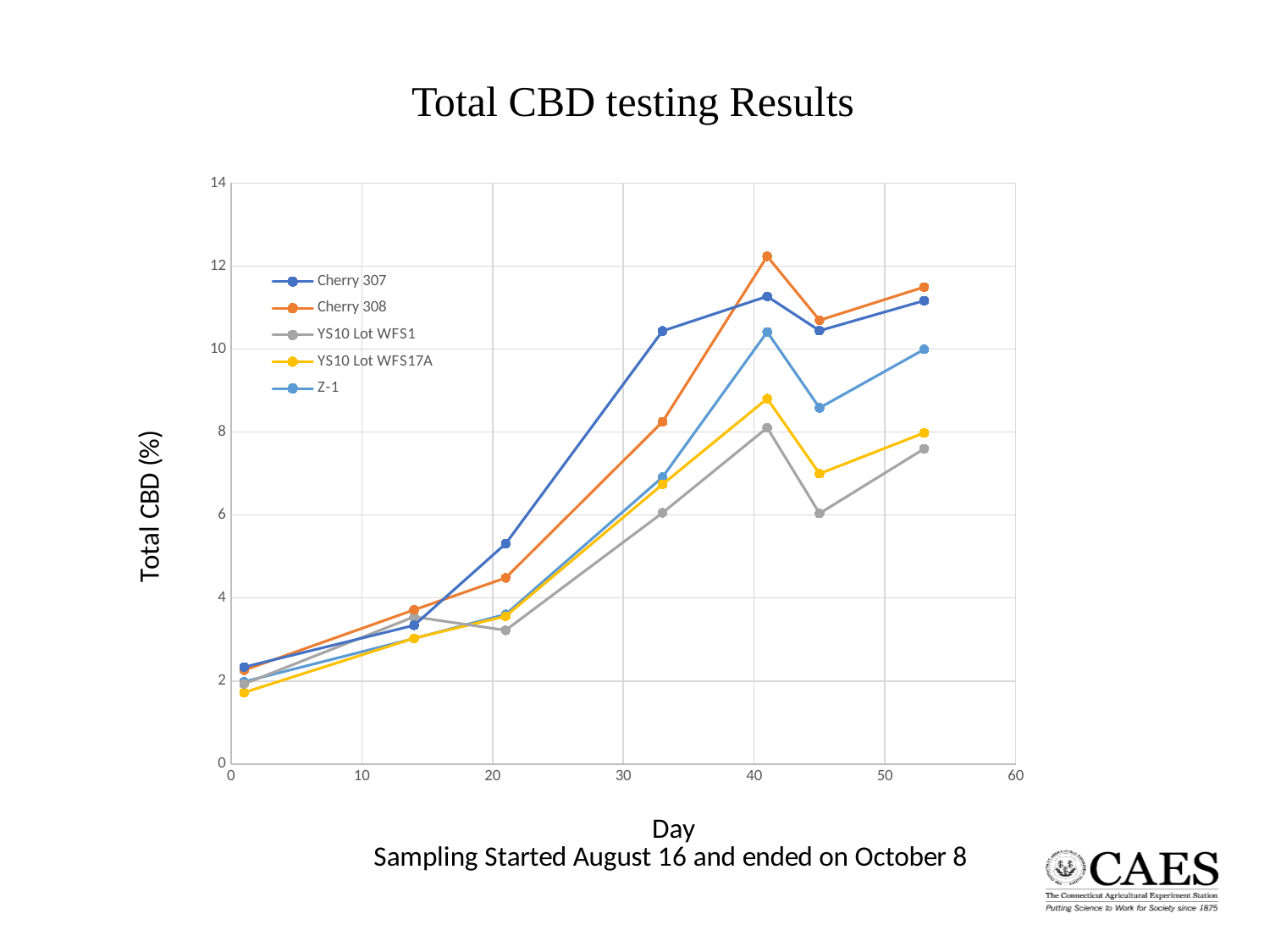
At day 21, which is larger: Cherry 307 or Cherry 308? Cherry 307 Which series has the highest Total CBD value at day 33? Cherry 307 Is the value for Cherry 307 at day 33 greater or less than 10? greater Is the value for YS10 Lot WFS1 at day 45 greater or less than 8? less Which series has the highest Total CBD value at day 41? Cherry 308 Overall, do the Total CBD values rise or fall from day 1 to day 53? rise At day 53, which is larger: Cherry 308 or Z-1? Cherry 308 How many sampling points are plotted for each series? 7 Which series has the lowest Total CBD value at day 45? YS10 Lot WFS1 Is the value for Z-1 at day 45 greater or less than 8? greater What kind of chart is shown on the slide? line chart How many series does the legend list? 5